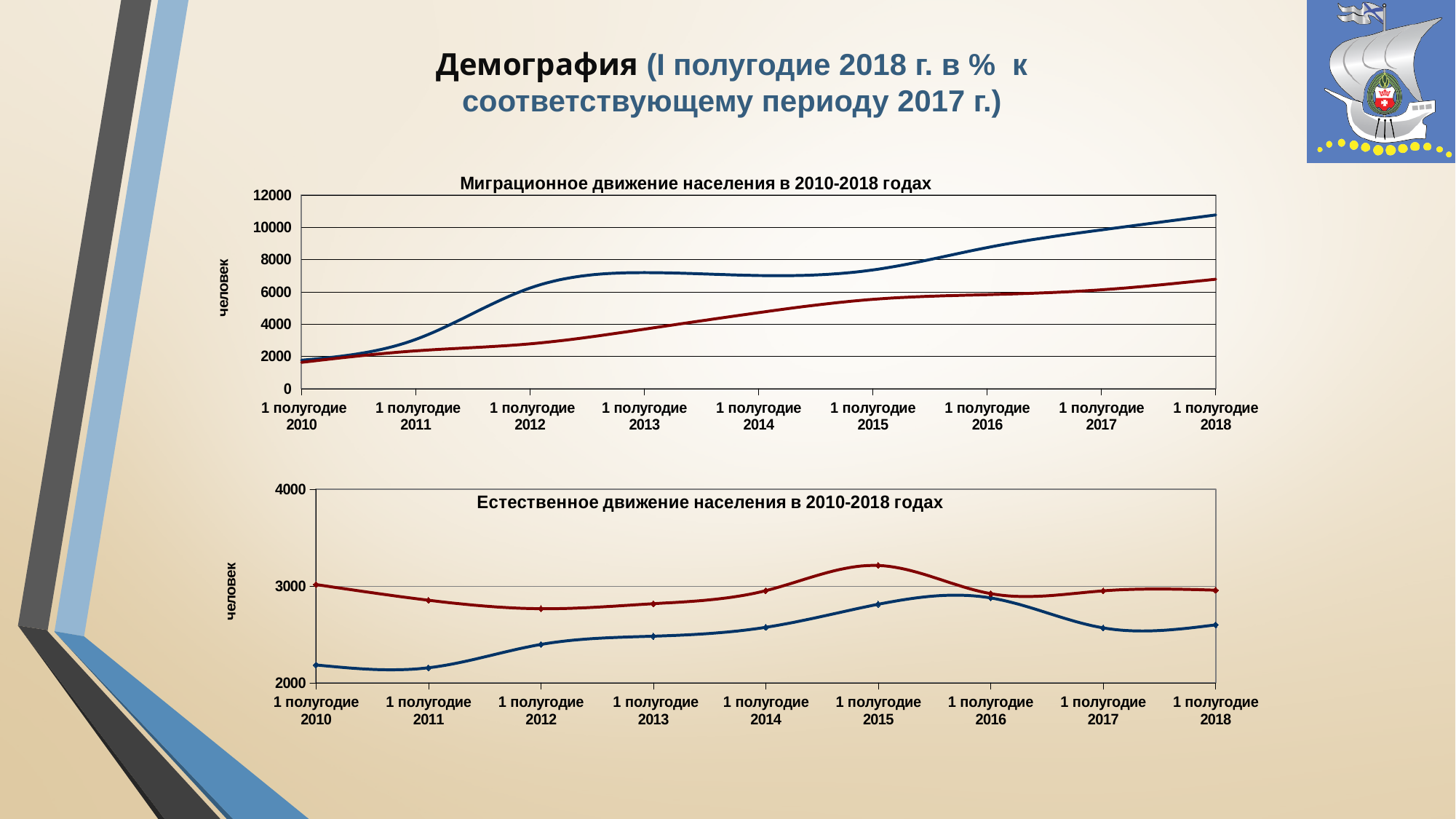
In the chart "Естественное движение населения в 2010-2018 годах", which line is higher at 1 полугодие 2010, the red line or the blue line? the red line In the chart "Естественное движение населения в 2010-2018 годах", is the value of the blue line for 1 полугодие 2010 greater or less than 3000? less What is the label on the vertical axis of the chart "Естественное движение населения в 2010-2018 годах"? человек In the chart "Миграционное движение населения в 2010-2018 годах", is the value of the blue line for 1 полугодие 2018 greater or less than 10000? greater In the chart "Миграционное движение населения в 2010-2018 годах", which line is higher at 1 полугодие 2018, the blue line or the red line? the blue line What kind of chart is the chart titled "Миграционное движение населения в 2010-2018 годах"? line chart In the chart "Миграционное движение населения в 2010-2018 годах", is the value of the blue line for 1 полугодие 2013 greater or less than 6000? greater In the chart "Естественное движение населения в 2010-2018 годах", in which period does the red line reach its highest value? 1 полугодие 2015 In the chart "Миграционное движение населения в 2010-2018 годах", how many periods are shown on the x axis? 9 In the chart "Миграционное движение населения в 2010-2018 годах", does the blue line rise or fall from 1 полугодие 2010 to 1 полугодие 2018? rise